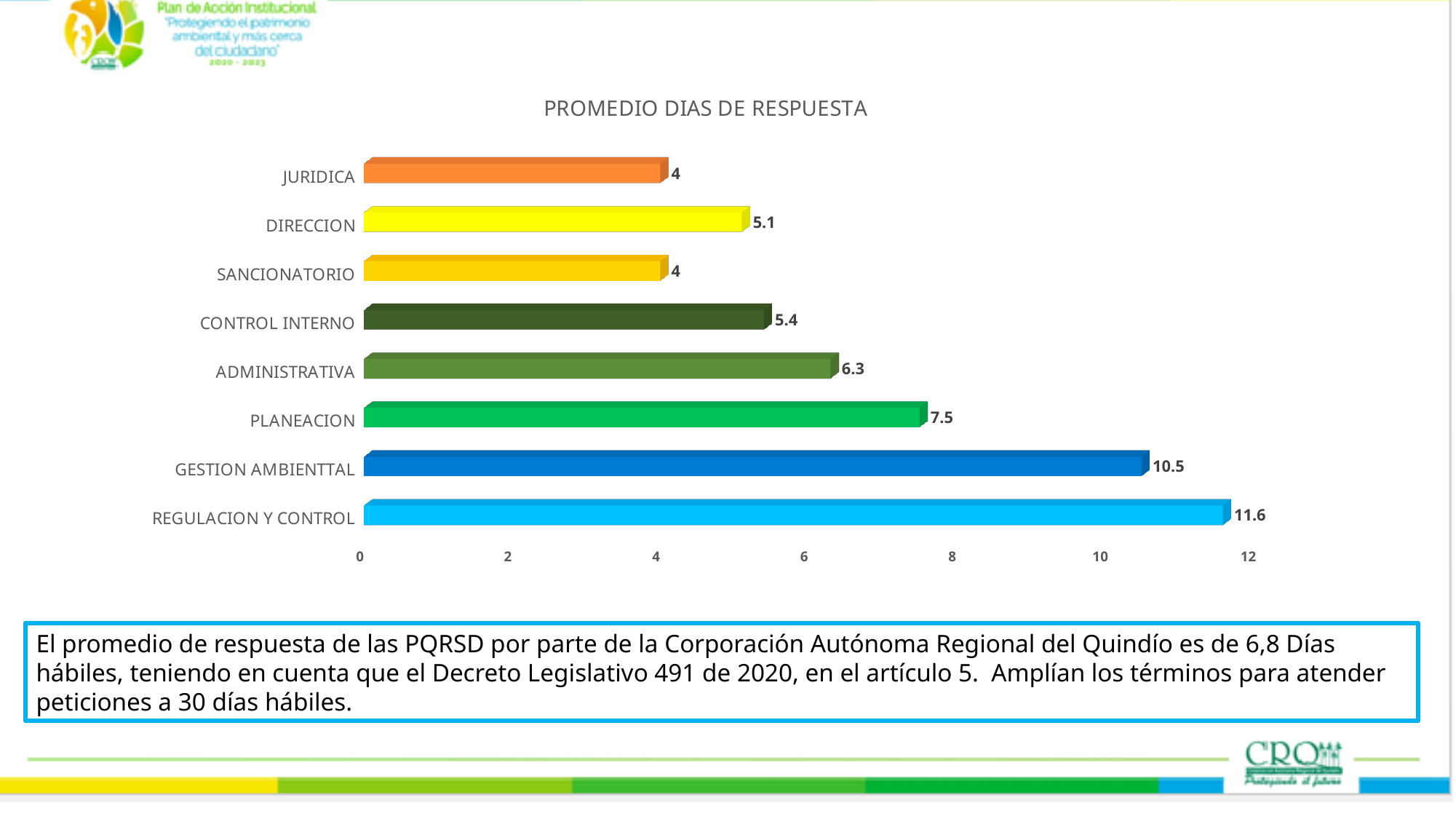
What is the difference between the values for GESTION AMBIENTTAL and ADMINISTRATIVA? 4.2 Which category has the highest value? REGULACION Y CONTROL What is the value for PLANEACION? 7.5 How many categories are shown in the chart? 8 What is the difference between the values for REGULACION Y CONTROL and JURIDICA? 7.6 What is the title of the chart? PROMEDIO DIAS DE RESPUESTA Which categories share the lowest value of 4? JURIDICA and SANCIONATORIO What is the value for REGULACION Y CONTROL? 11.6 Is the value for GESTION AMBIENTTAL greater or less than 10? greater What is the value for CONTROL INTERNO? 5.4 What kind of chart is shown on the slide? bar chart Which is larger, the value for DIRECCION or the value for CONTROL INTERNO? CONTROL INTERNO